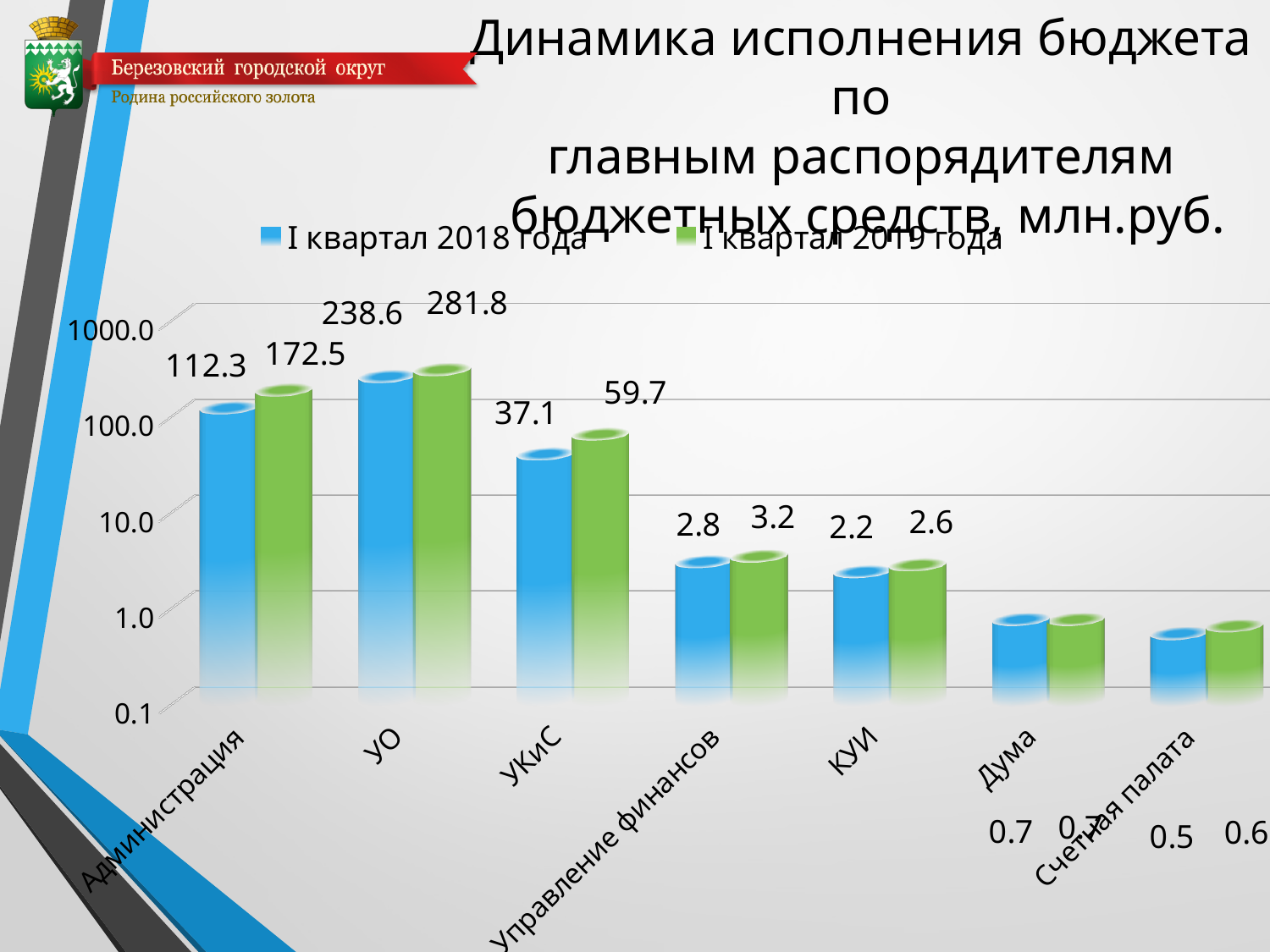
How many series does the legend list? 2 What is the value for Администрация in I квартал 2018 года? 112.3 What is the difference between the I квартал 2019 года and I квартал 2018 года values for Администрация? 60.2 What is the value for УО in I квартал 2019 года? 281.8 How many categories are shown on the x axis? 7 Which is larger for КУИ: the I квартал 2018 года value or the I квартал 2019 года value? I квартал 2019 года What is the value for УКиС in I квартал 2019 года? 59.7 What kind of chart is shown on the slide? bar chart Which category has the highest value in I квартал 2019 года? УО Which category has the lowest value in I квартал 2018 года? Счетная палата Is the value for УКиС in I квартал 2018 года greater or less than 10.0? greater What is the value for Управление финансов in I квартал 2018 года? 2.8